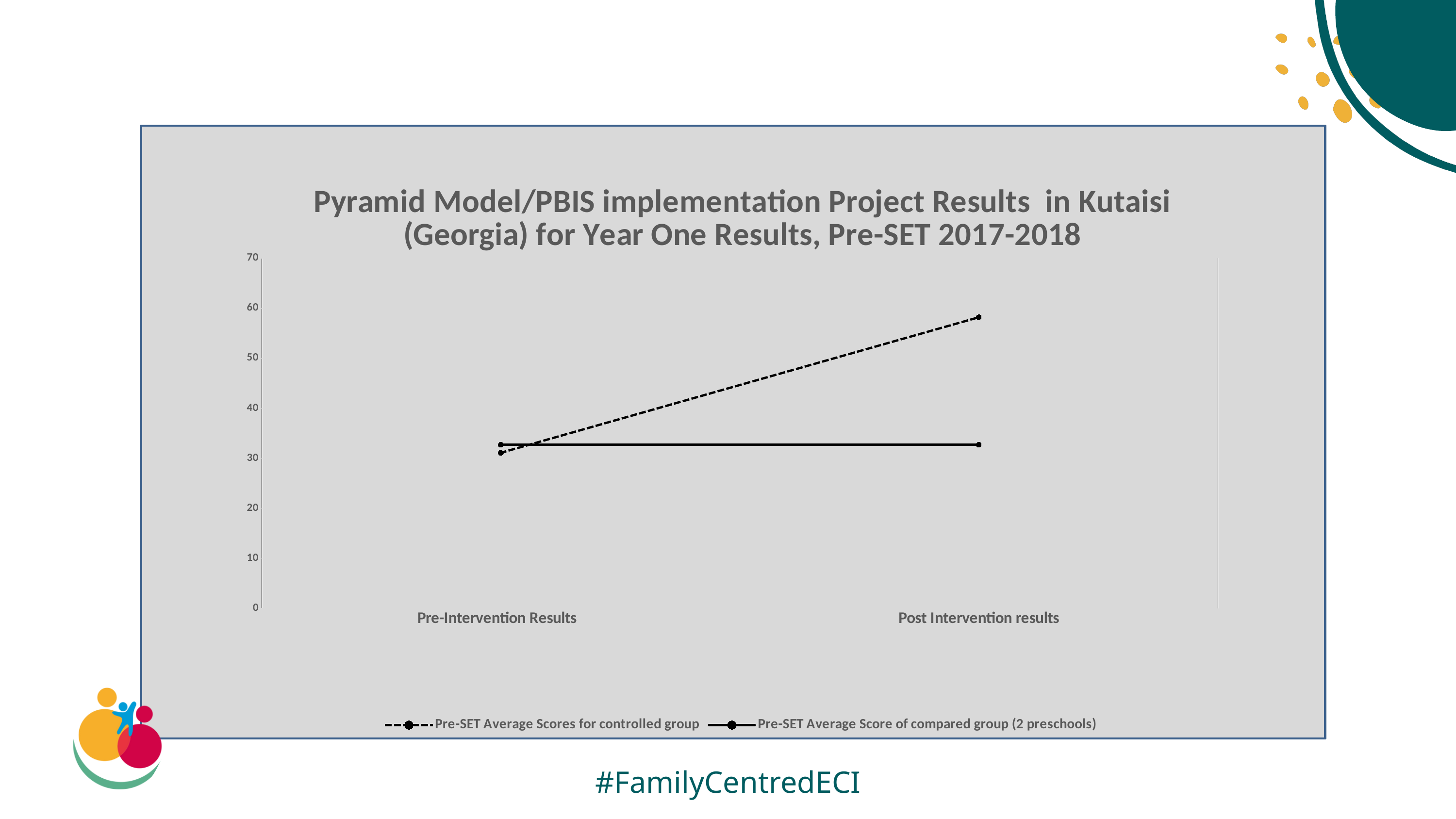
What kind of chart is shown on the slide? line chart Is the value for the controlled group at Post Intervention results greater or less than 50? greater Is the value for the compared group (2 preschools) at Pre-Intervention Results greater or less than 20? greater Does the Pre-SET Average Scores for controlled group series rise or fall from Pre-Intervention Results to Post Intervention results? rise Is the value for the controlled group at Pre-Intervention Results greater or less than 40? less At Post Intervention results, which series has the higher value? Pre-SET Average Scores for controlled group Does the Pre-SET Average Score of compared group (2 preschools) series rise, fall or stay flat from Pre-Intervention Results to Post Intervention results? stays flat How many series does the legend list? 2 How many categories are shown on the x axis? 2 For the controlled group series, which category has the highest value? Post Intervention results Which series is drawn with a dashed line? Pre-SET Average Scores for controlled group